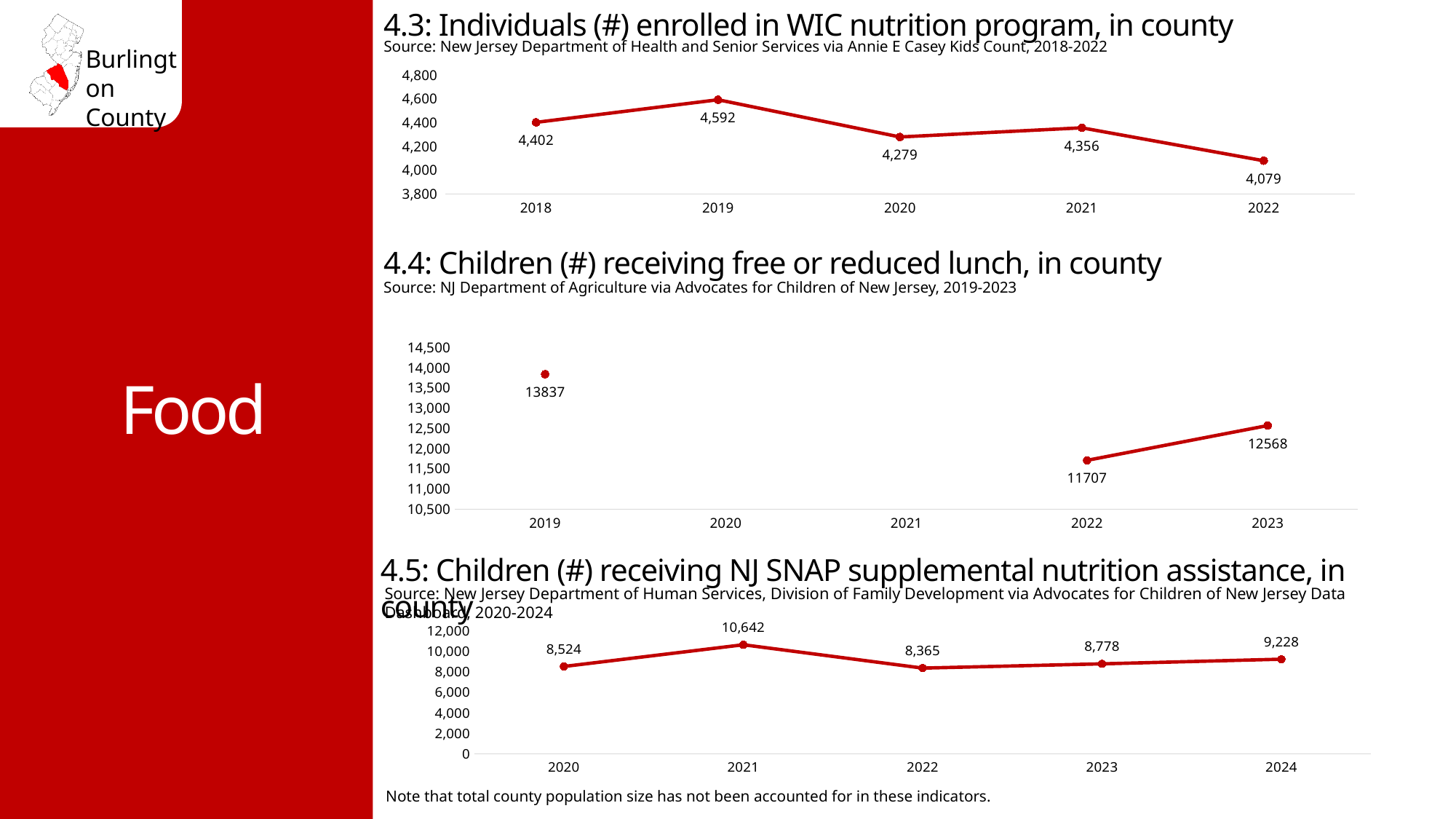
In the chart '4.3: Individuals (#) enrolled in WIC nutrition program, in county', how many years are plotted? 5 In the chart '4.3: Individuals (#) enrolled in WIC nutrition program, in county', what is the value for 2019? 4,592 In the chart '4.4: Children (#) receiving free or reduced lunch, in county', which year has the highest plotted value? 2019 In the chart '4.4: Children (#) receiving free or reduced lunch, in county', what is the value for 2019? 13837 In the chart '4.5: Children (#) receiving NJ SNAP supplemental nutrition assistance, in county', which year has the lowest value? 2022 In the chart '4.3: Individuals (#) enrolled in WIC nutrition program, in county', what is the difference between the 2018 and 2022 values? 323 What kind of chart is '4.5: Children (#) receiving NJ SNAP supplemental nutrition assistance, in county'? line chart In the chart '4.5: Children (#) receiving NJ SNAP supplemental nutrition assistance, in county', what is the value for 2021? 10,642 In the chart '4.4: Children (#) receiving free or reduced lunch, in county', do values rise or fall from 2022 to 2023? rise In the chart '4.4: Children (#) receiving free or reduced lunch, in county', how many data points are plotted? 3 In the chart '4.5: Children (#) receiving NJ SNAP supplemental nutrition assistance, in county', is the value for 2023 larger or smaller than the value for 2024? smaller In the chart '4.3: Individuals (#) enrolled in WIC nutrition program, in county', which year has the lowest value? 2022